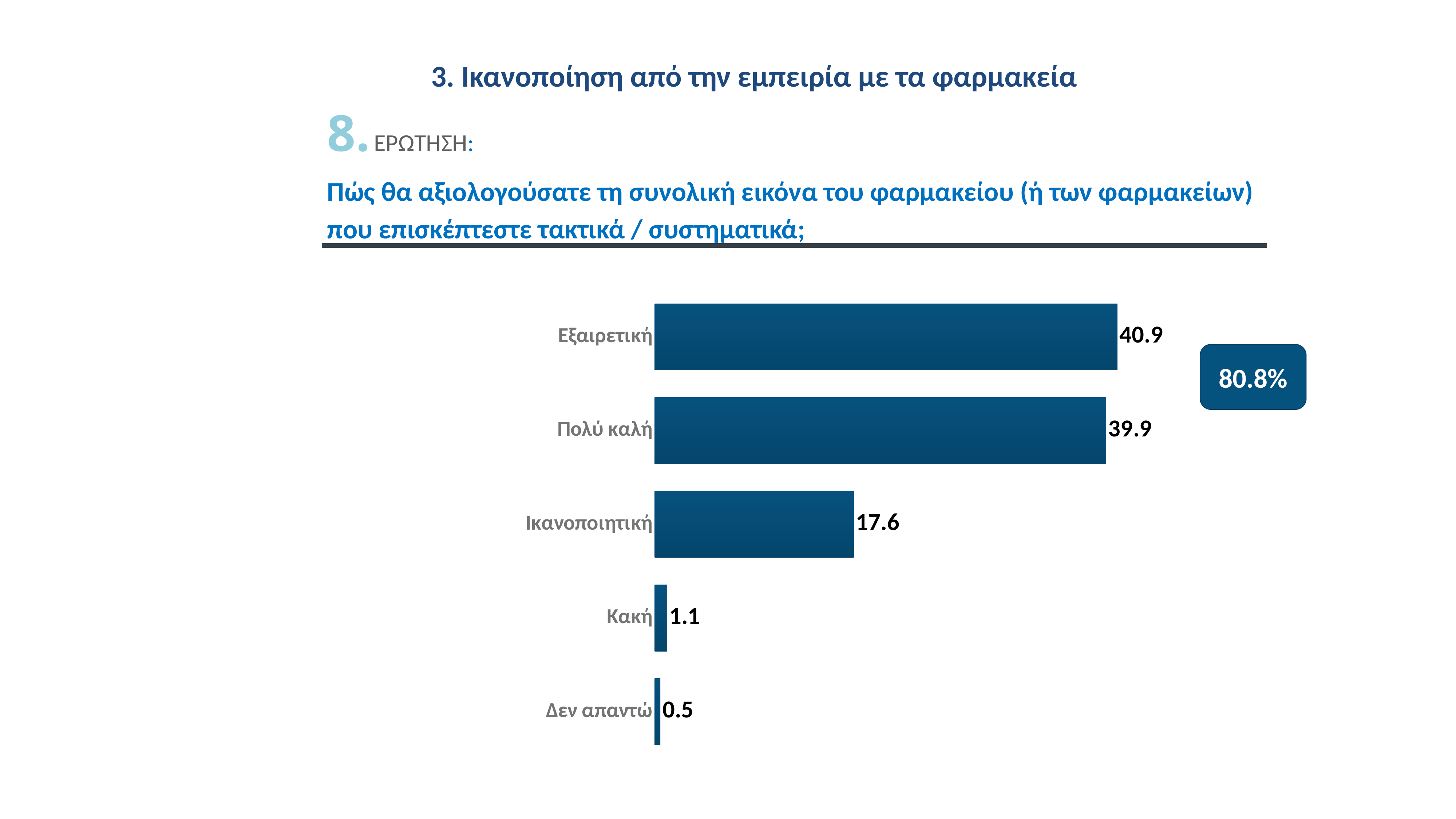
What is the difference between the values for Εξαιρετική and Ικανοποιητική? 23.3 What is the difference between the values for Πολύ καλή and Κακή? 38.8 Which is larger, the value for Ικανοποιητική or the value for Κακή? Ικανοποιητική Which category has the highest value? Εξαιρετική What is the value for Ικανοποιητική? 17.6 Which category has the lowest value? Δεν απαντώ How many categories are shown in the chart? 5 What is the value for Εξαιρετική? 40.9 What is the value for Δεν απαντώ? 0.5 What kind of chart is shown on the slide? Bar chart What is the value for Κακή? 1.1 What is the value for Πολύ καλή? 39.9